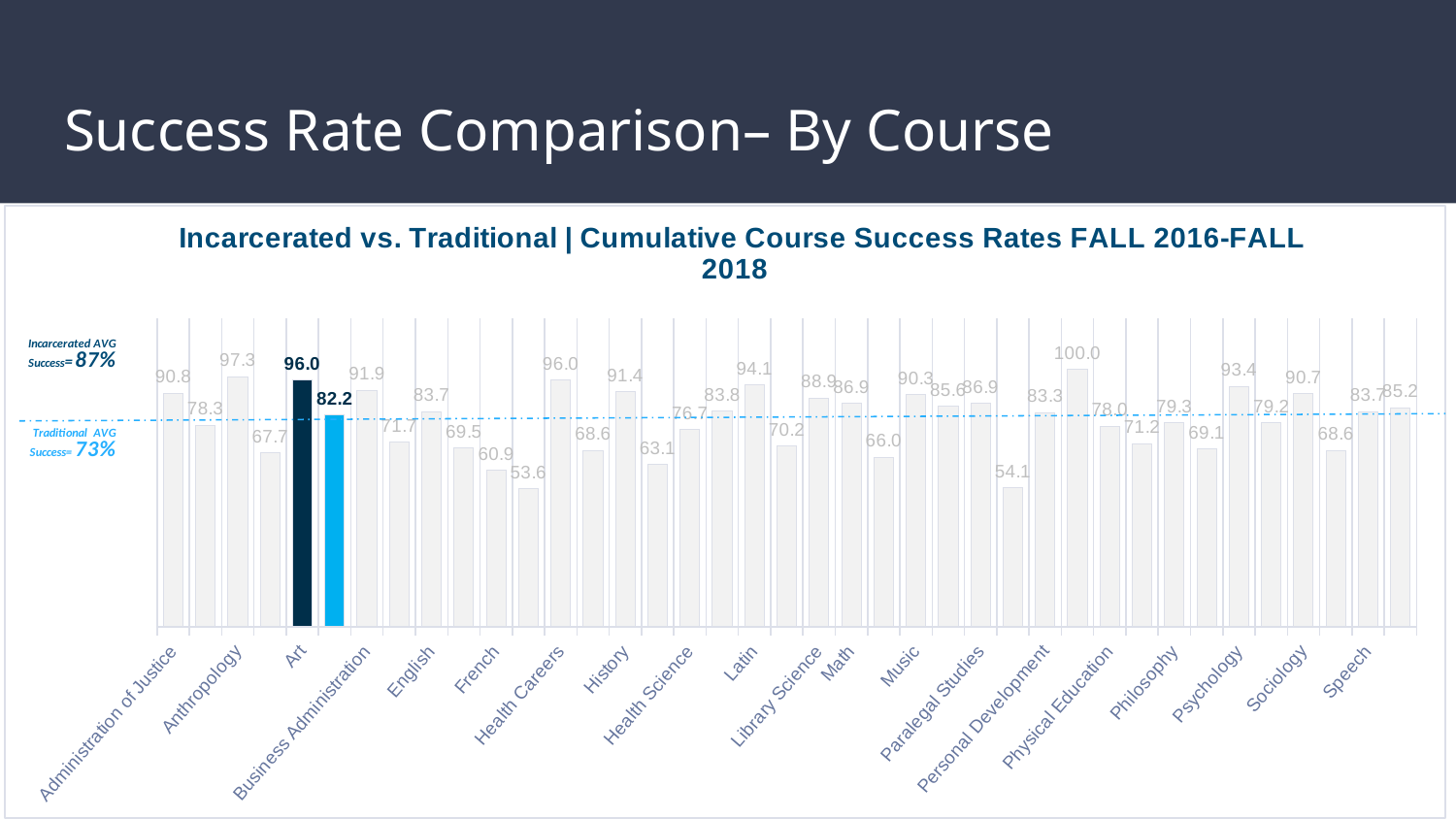
What is the Traditional AVG Success rate shown on the chart? 73% For Art, which highlighted bar is larger, the dark blue one or the light blue one? The dark blue one What is the Incarcerated AVG Success rate shown on the chart? 87% What is the value of the light blue highlighted bar for Art? 82.2 What is the lowest value labeled on any bar in the chart? 53.6 How many courses are listed along the x axis of the chart? 20 What is the title of the chart? Incarcerated vs. Traditional | Cumulative Course Success Rates FALL 2016-FALL 2018 What kind of chart is shown on the slide? Bar chart What is the highest value labeled on any bar in the chart? 100.0 Which course's bars are highlighted in blue rather than grey? Art What is the difference between the two highlighted Art bars (96.0 and 82.2)? 13.8 What is the value of the dark blue highlighted bar for Art? 96.0